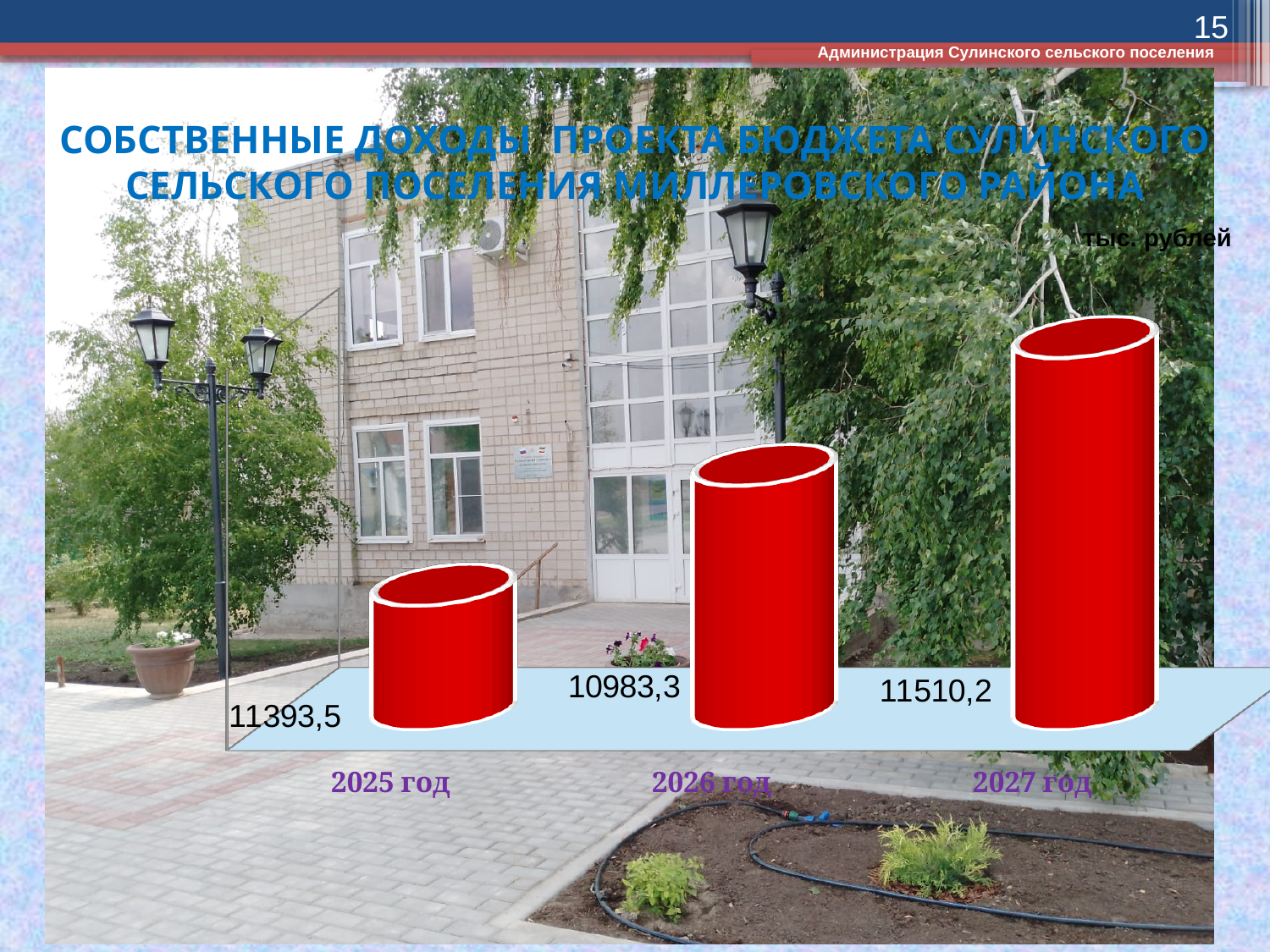
What is the value for 2027 год? 11510,2 What kind of chart is shown on the slide? Bar chart What is the value for 2026 год? 10983,3 Which is larger, the value for 2026 год or 2027 год? 2027 год Which year has the highest value? 2027 год How many years are shown in the chart? 3 What is the value for 2025 год? 11393,5 What colour are the bars in the chart? Red What is the difference between the values for 2027 год and 2026 год? 526,9 What is the difference between the values for 2027 год and 2025 год? 116,7 In what units are the chart values given? тыс. рублей